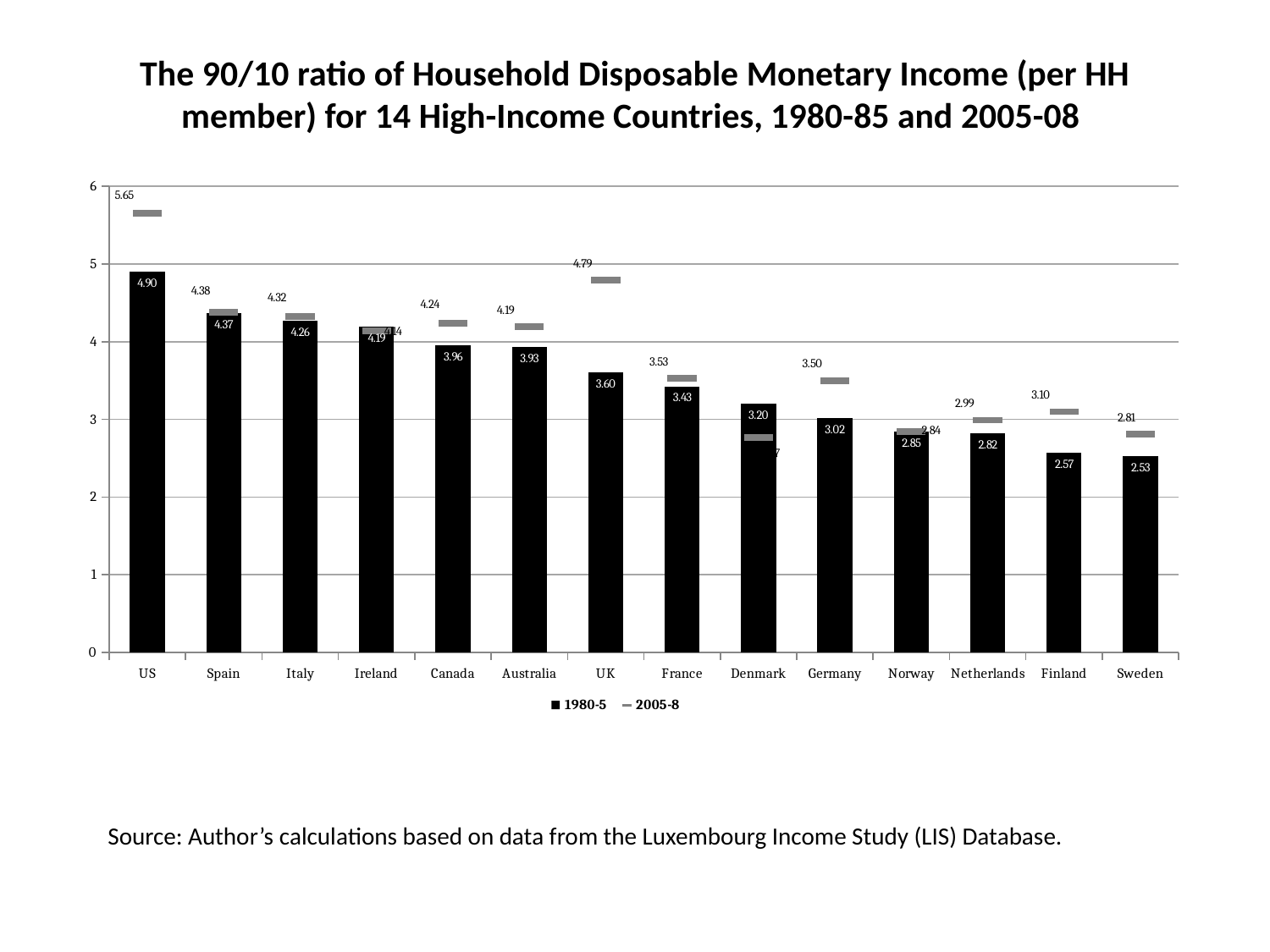
How many countries are shown on the x axis? 14 What kind of chart is shown on the slide? bar chart Which country has the highest 2005-8 value? US What is the difference between the 2005-8 and 1980-5 values for the UK? 1.19 Is the 1980-5 value for France greater or less than 4? less What is the 2005-8 value for Finland? 3.10 Which country has the lowest 1980-5 value? Sweden What is the 2005-8 value for the UK? 4.79 What is the 1980-5 value for Germany? 3.02 What is the 1980-5 value for the US? 4.90 How many series does the legend list? 2 Which is larger for Canada: the 1980-5 value or the 2005-8 value? 2005-8